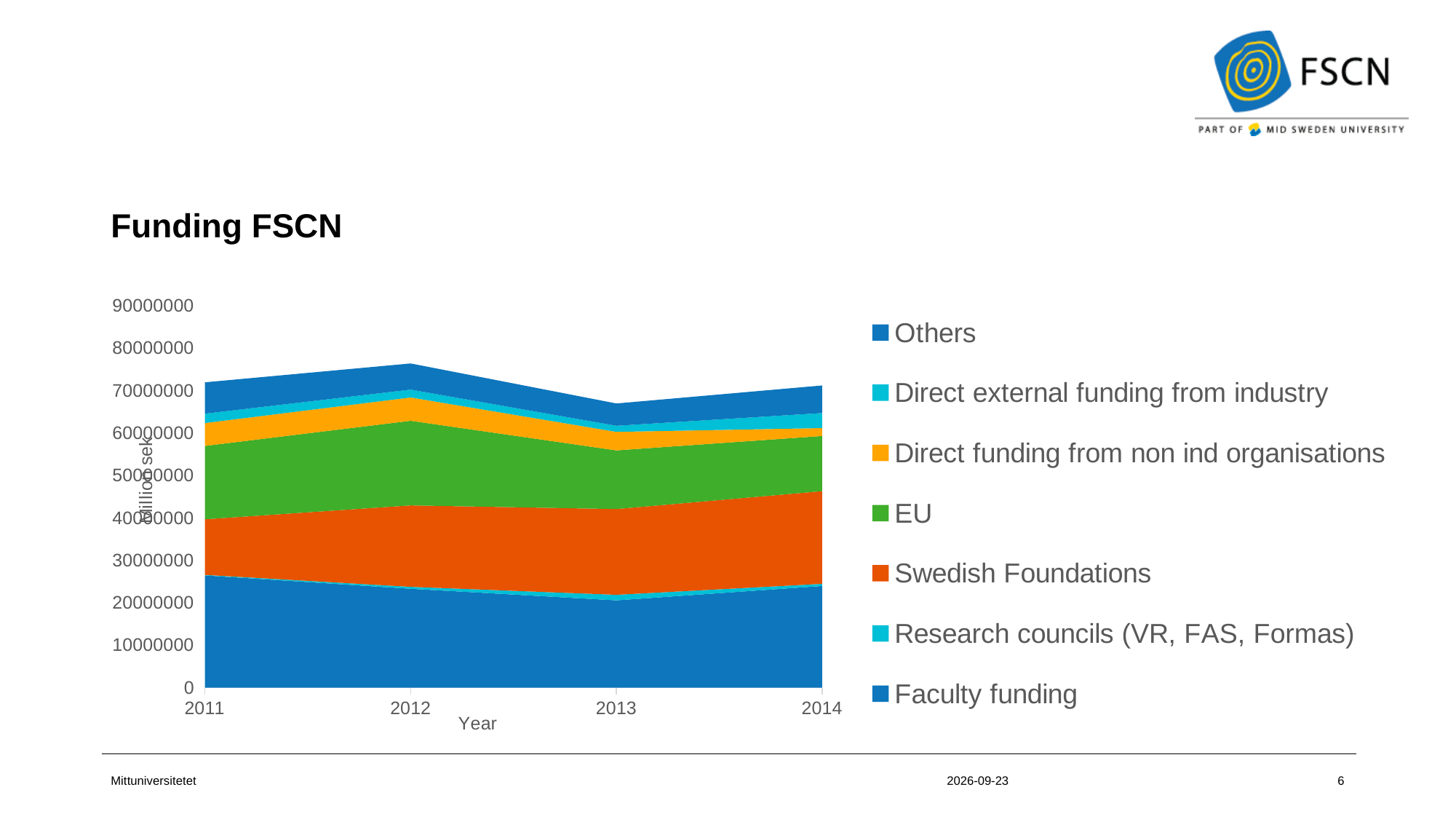
Is the total funding in 2013 greater or less than 70000000? less How many series does the legend list? 7 What kind of chart is shown on the slide? Stacked area chart How many years are plotted along the x axis? 4 Does Faculty funding rise or fall from 2011 to 2013? fall Which year has the lowest total funding? 2013 Is the value for Faculty funding in 2014 greater or less than 30000000? less What is the title of the x axis? Year Is the total funding in 2012 greater or less than 70000000? greater Which series is listed first in the legend? Others Which year has the highest total funding? 2012